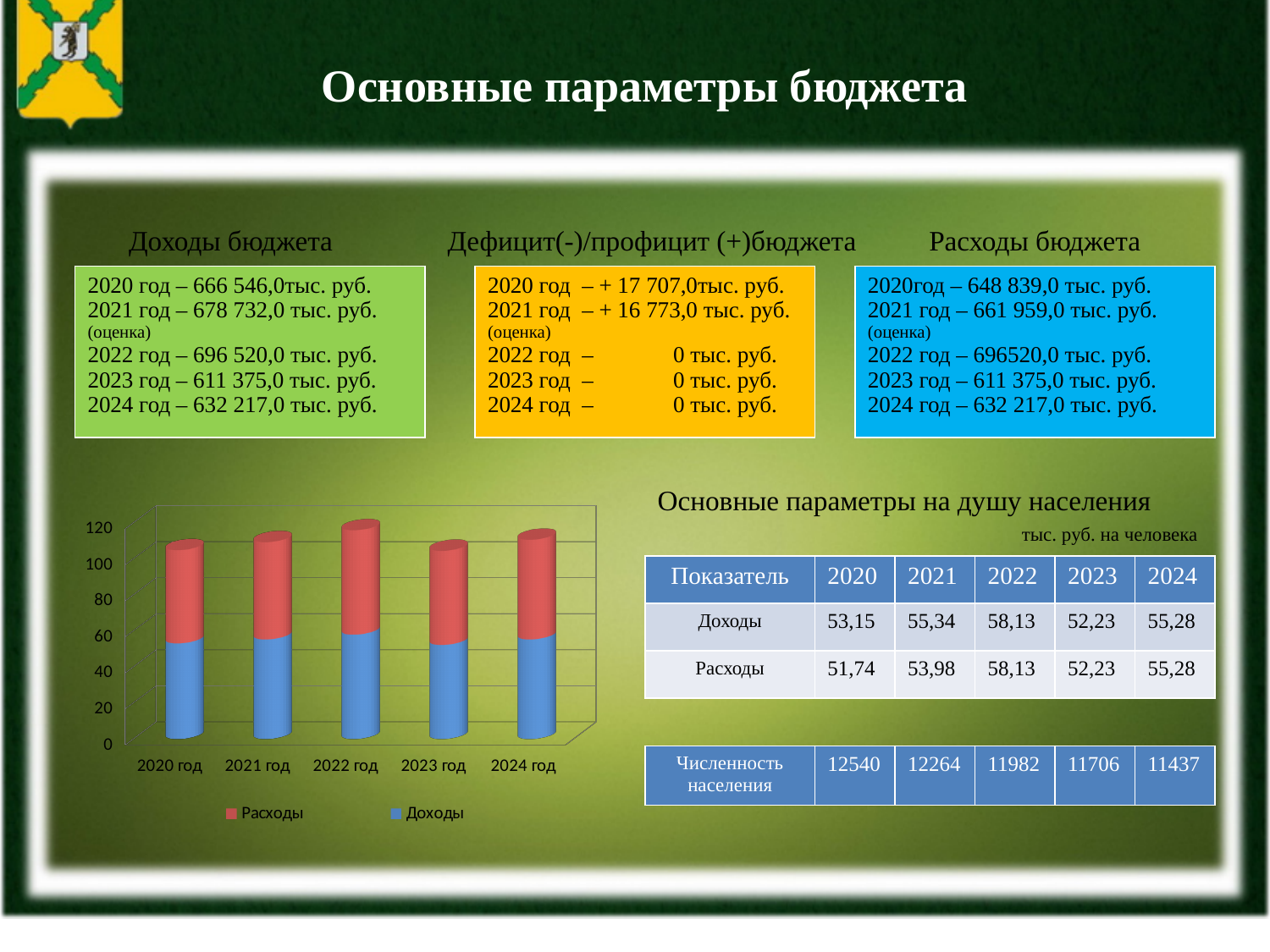
What kind of chart is shown on the slide? bar chart Is the Доходы segment for 2020 год greater or less than 40? greater Is the total stacked bar for 2023 год greater or less than 120? less Is the total stacked bar for 2022 год greater or less than 100? greater Which year has the tallest stacked bar on the chart? 2022 год How many series does the chart's legend list? 2 Which stacked bar is taller, 2020 год or 2022 год? 2022 год Which series forms the bottom segment of each stacked bar? Доходы How many year categories are plotted on the chart's x axis? 5 Which stacked bar is taller, 2022 год or 2023 год? 2022 год Which series is shown in red on the chart? Расходы Do the stacked bar totals rise or fall from 2020 год to 2022 год? rise